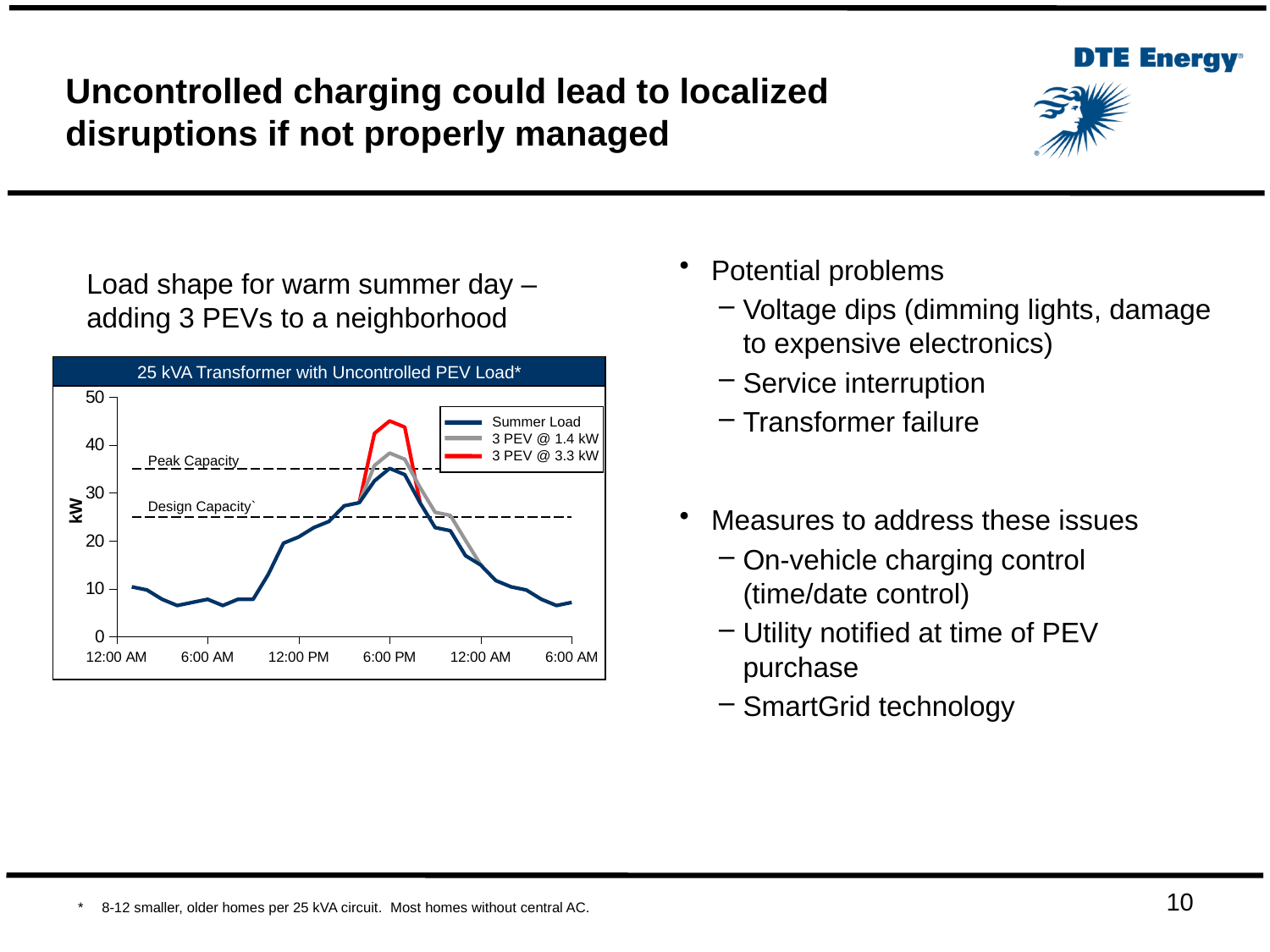
Is the peak value of the 3 PEV @ 1.4 kW series greater or less than 30? greater What kind of chart is shown on the slide? line chart Which series has a higher peak, Summer Load or 3 PEV @ 1.4 kW? 3 PEV @ 1.4 kW Is the peak value of the 3 PEV @ 3.3 kW series greater or less than 40? greater Which series reaches the highest peak value on the chart? 3 PEV @ 3.3 kW Does the Summer Load rise or fall between 6:00 PM and 6:00 AM the next day? fall How many series does the chart legend list? 3 What is the title of the chart? 25 kVA Transformer with Uncontrolled PEV Load* Does the Summer Load rise or fall between 6:00 AM and 6:00 PM? rise What is the label on the vertical axis of the chart? kW Is the Summer Load value at 12:00 AM greater or less than 20? less